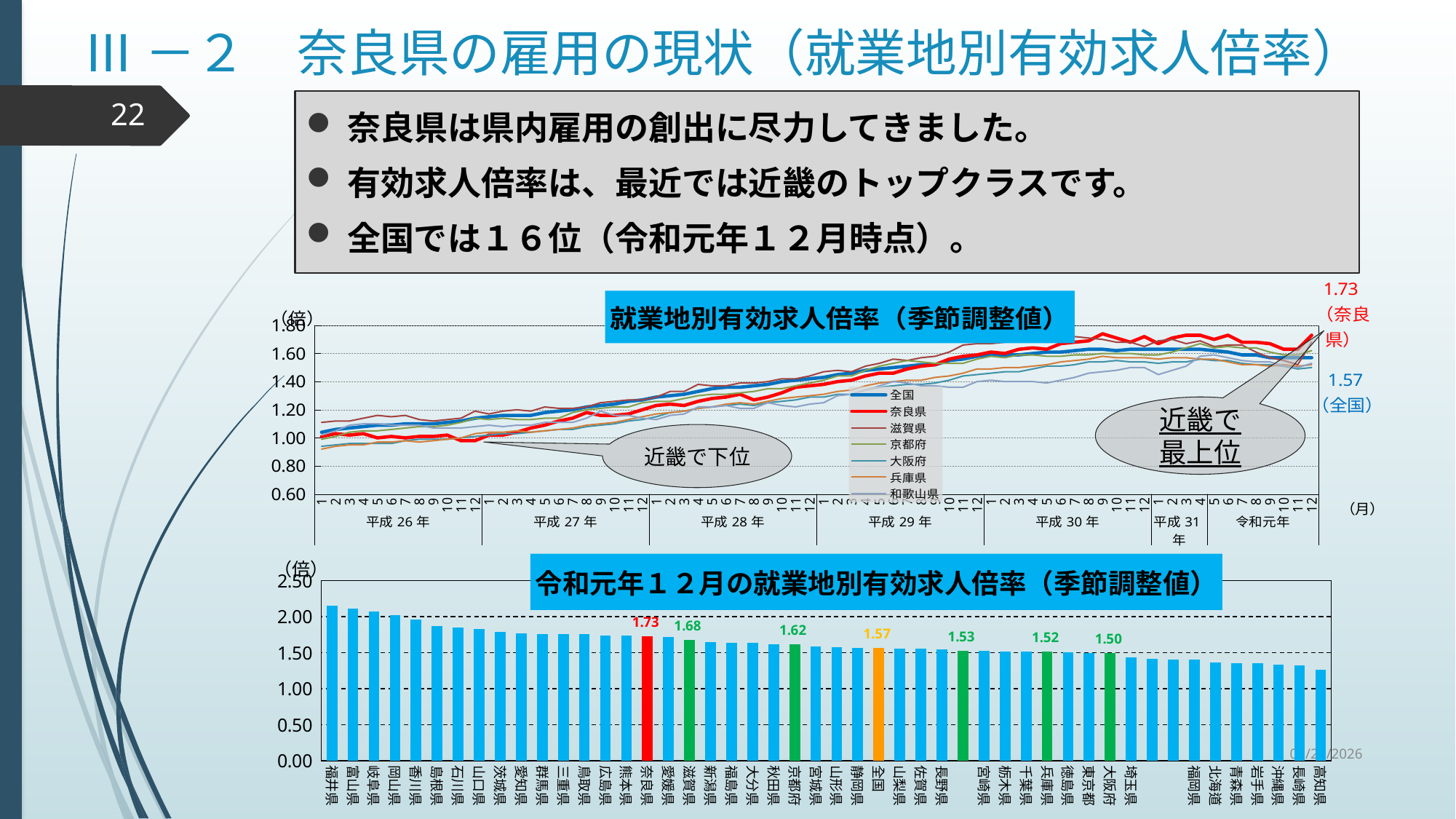
In the top line chart, does the 奈良県 line generally rise or fall from 平成26年 to 令和元年? rise In the bottom bar chart, what is the value for 全国? 1.57 In the bottom bar chart, is the value for 福井県 greater or less than 2.00? greater In the bottom bar chart, which prefecture has the lowest value? 高知県 In the bottom bar chart, which prefecture has the highest value? 福井県 In the bottom bar chart (令和元年１２月の就業地別有効求人倍率), what is the value for 奈良県? 1.73 How many series does the legend of the top chart (就業地別有効求人倍率（季節調整値）) list? 7 In the bottom bar chart, what is the difference between the values for 奈良県 and 全国? 0.16 In the bottom bar chart, what is the value for 大阪府? 1.50 In the bottom bar chart, what is the value for 滋賀県? 1.68 What kind of chart is the top chart (就業地別有効求人倍率（季節調整値）)? line chart In the bottom bar chart, which is larger, the value for 京都府 or the value for 兵庫県? 京都府